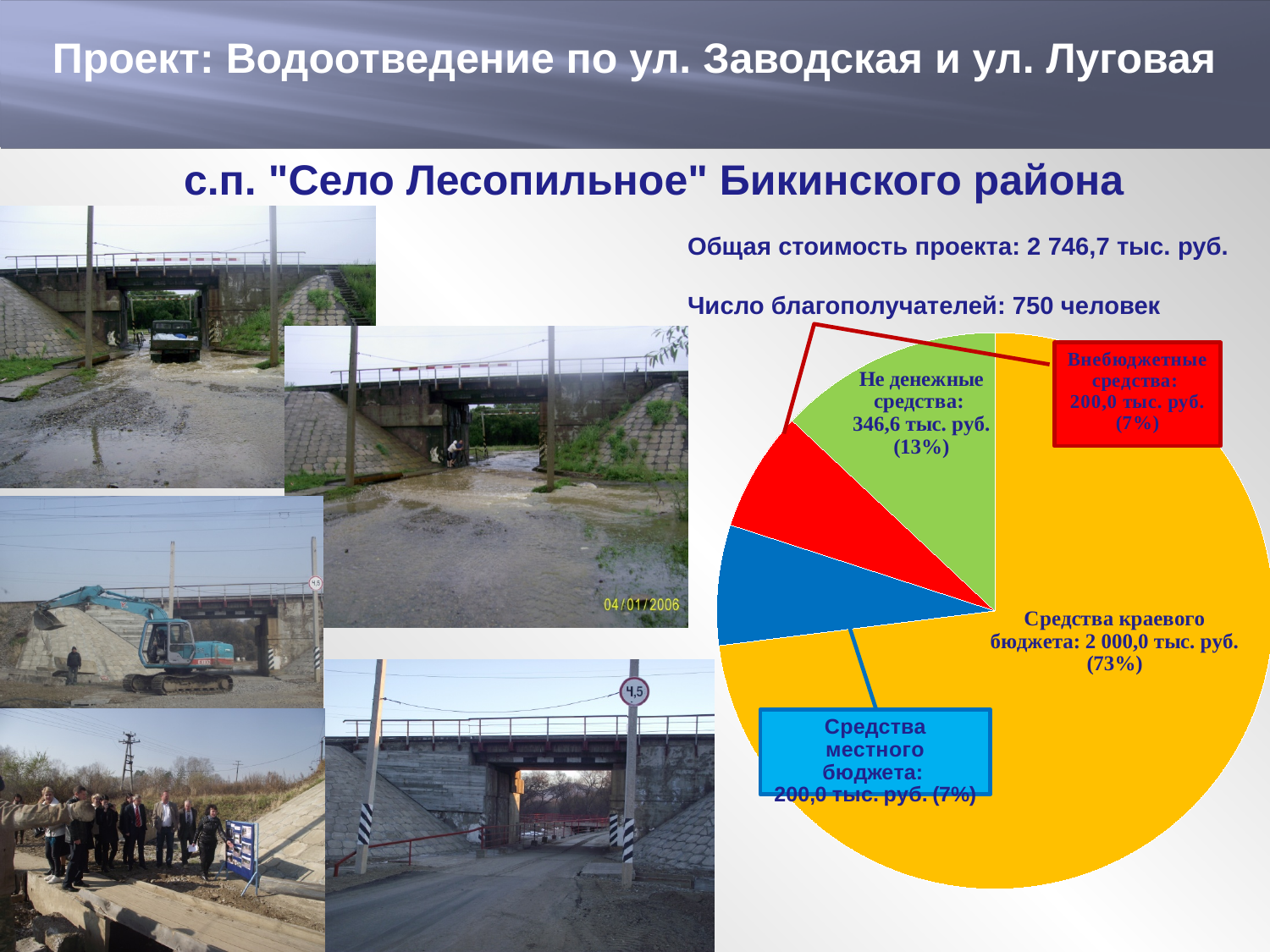
What share of the pie does Средства местного бюджета represent? 7% Which slice of the pie chart is the largest? Средства краевого бюджета What is the difference between Средства краевого бюджета and Не денежные средства in the pie chart? 1 653,4 тыс. руб. Which is larger in the pie chart, Не денежные средства or Внебюджетные средства? Не денежные средства What is the value for Средства краевого бюджета in the pie chart? 2 000,0 тыс. руб. What is the value for Не денежные средства in the pie chart? 346,6 тыс. руб. What kind of chart is shown on the slide? pie chart What is the value for Внебюджетные средства in the pie chart? 200,0 тыс. руб. What colour is the Средства краевого бюджета slice in the pie chart? yellow How many slices does the pie chart have? 4 What share of the pie does Средства краевого бюджета represent? 73% What share of the pie does Не денежные средства represent? 13%